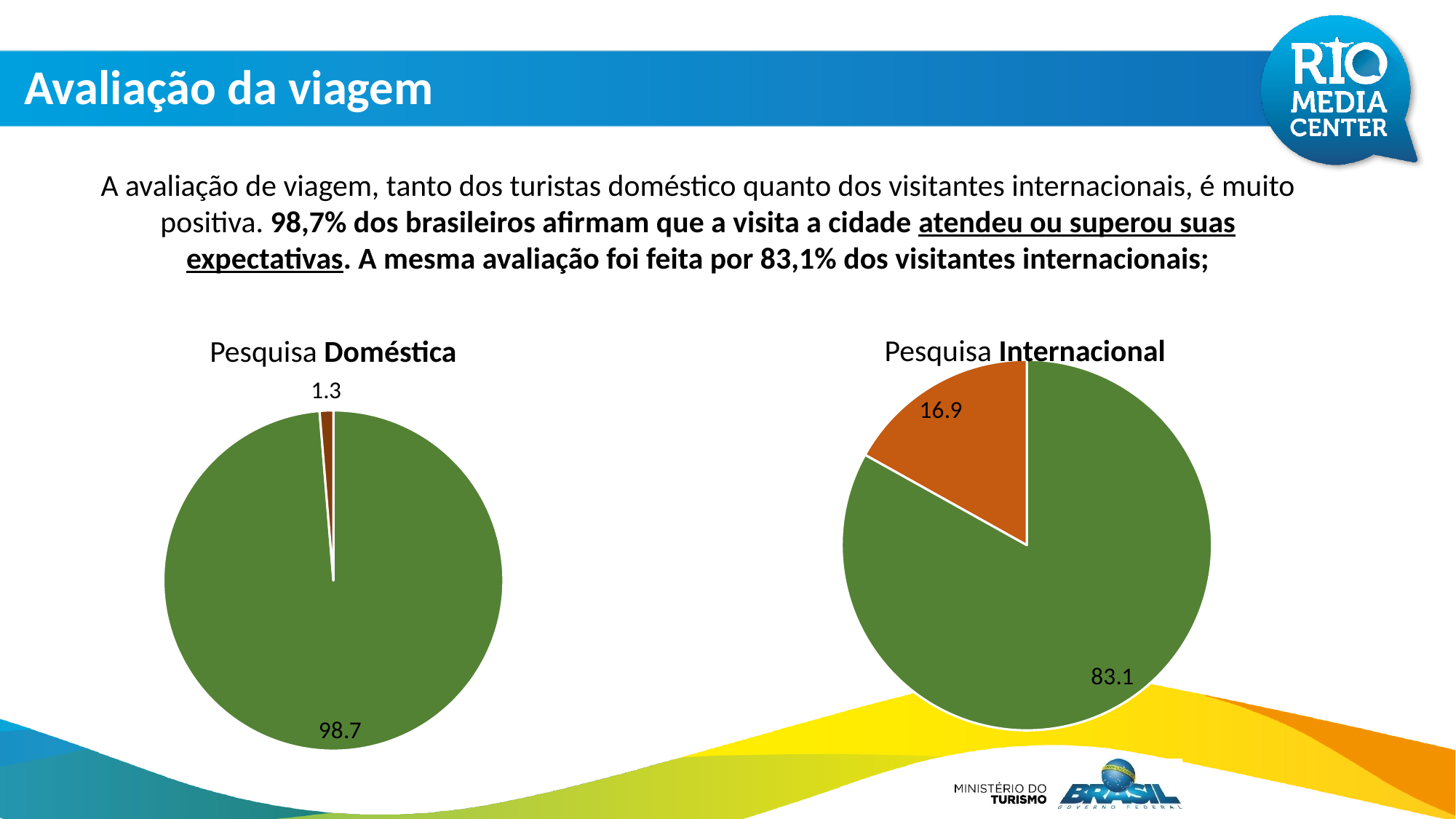
In the "Pesquisa Internacional" chart, what value is shown for the orange slice? 16.9 In the "Pesquisa Internacional" chart, what value is shown for the green slice? 83.1 How many slices does the "Pesquisa Doméstica" pie chart have? 2 What kind of chart is the "Pesquisa Doméstica" chart? pie chart What kind of chart is the "Pesquisa Internacional" chart? pie chart How many slices does the "Pesquisa Internacional" pie chart have? 2 What is the difference between the two slice values in the "Pesquisa Internacional" chart? 66.2 In the "Pesquisa Internacional" chart, which slice is larger, the green one or the orange one? the green one Which chart has the larger orange slice, "Pesquisa Doméstica" or "Pesquisa Internacional"? Pesquisa Internacional What is the title of the pie chart on the left of the slide? Pesquisa Doméstica In the "Pesquisa Doméstica" chart, what value is shown for the green slice? 98.7 In the "Pesquisa Doméstica" chart, what value is shown for the small orange slice? 1.3